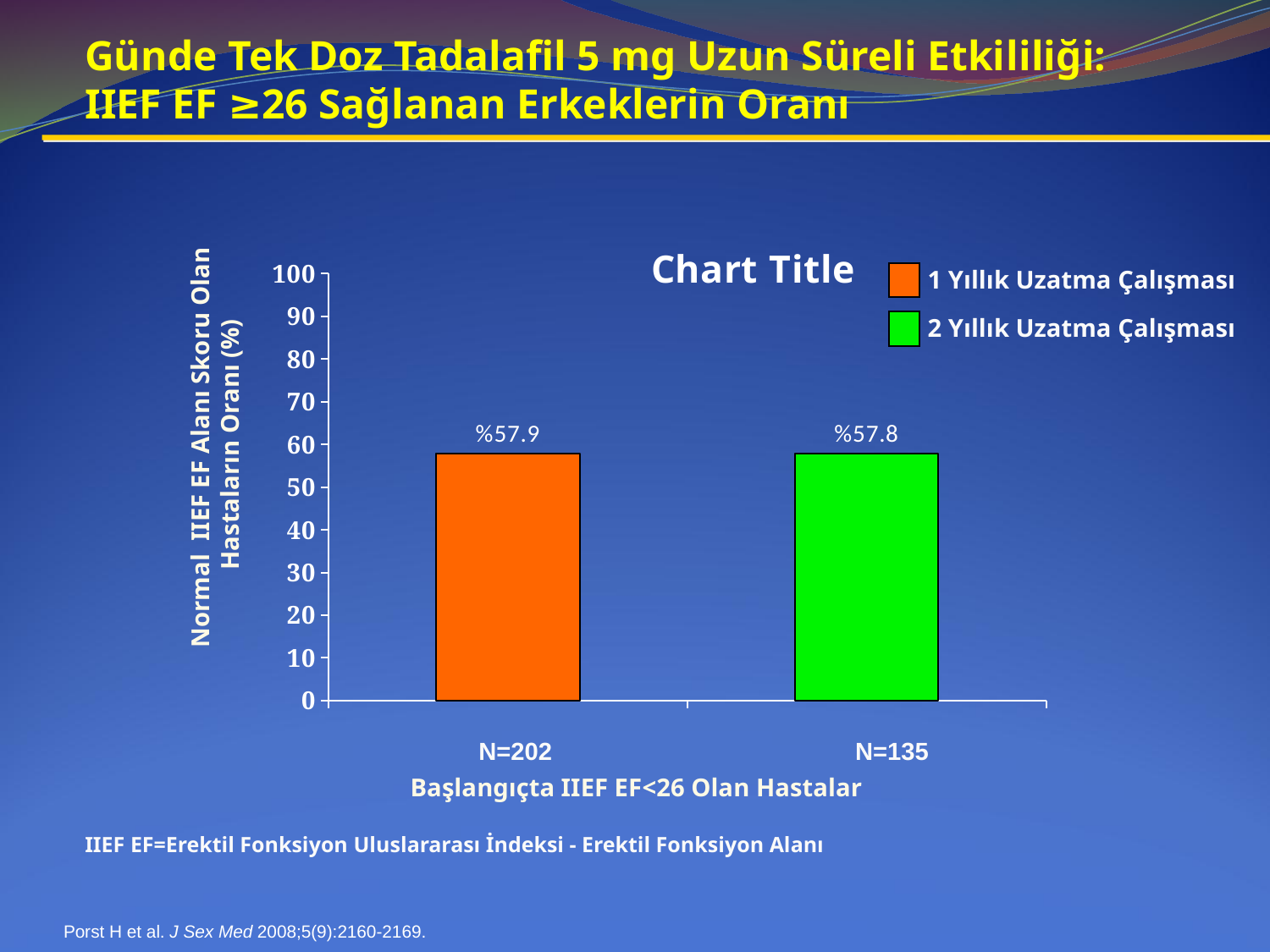
What is the value of the bar labelled N=135? %57.8 What is the difference between the 1 Yıllık Uzatma Çalışması value and the 2 Yıllık Uzatma Çalışması value? 0.1 What colour is the bar for 2 Yıllık Uzatma Çalışması? green Is the value for 1 Yıllık Uzatma Çalışması greater or less than 50? greater How many series does the legend list? 2 What is the value shown for the 1 Yıllık Uzatma Çalışması bar? %57.9 What kind of chart is shown on the slide? bar chart What is the value shown for the 2 Yıllık Uzatma Çalışması bar? %57.8 What is the value of the bar labelled N=202? %57.9 Is the value for 2 Yıllık Uzatma Çalışması greater or less than 60? less How many bars are plotted in the chart? 2 According to the data labels, which bar has the larger value: 1 Yıllık Uzatma Çalışması or 2 Yıllık Uzatma Çalışması? 1 Yıllık Uzatma Çalışması